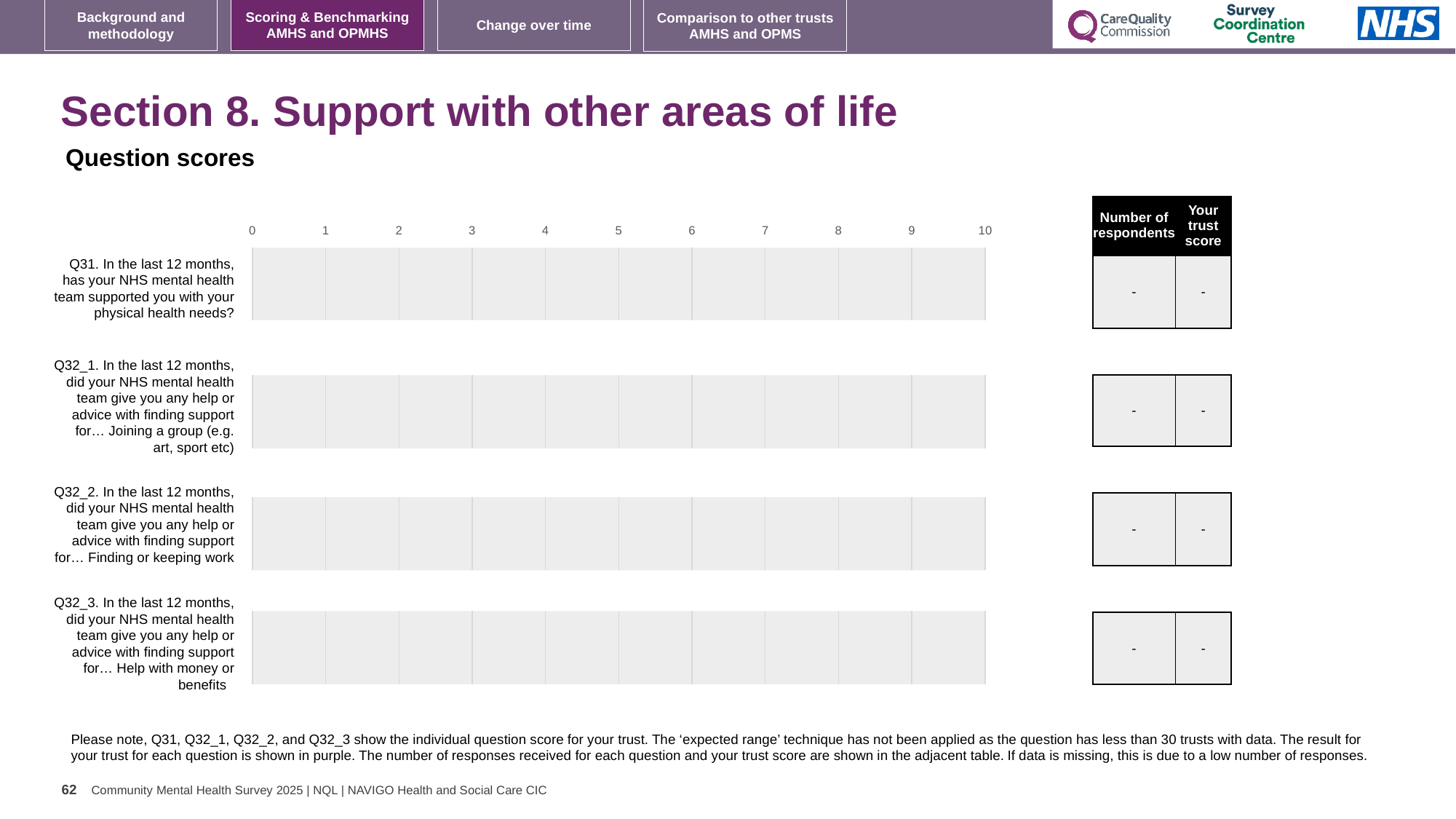
What is the 'Number of respondents' value shown in the table for Q32_3? - What kind of chart is shown on the slide? bar chart How many questions (categories) are listed on the chart? 4 What is the highest value shown on the chart's horizontal axis? 10 What is the lowest value shown on the chart's horizontal axis? 0 What is the 'Number of respondents' value shown in the table for Q32_1? - What is the 'Your trust score' value shown in the table for Q31? - What is the 'Your trust score' value shown in the table for Q32_2? -